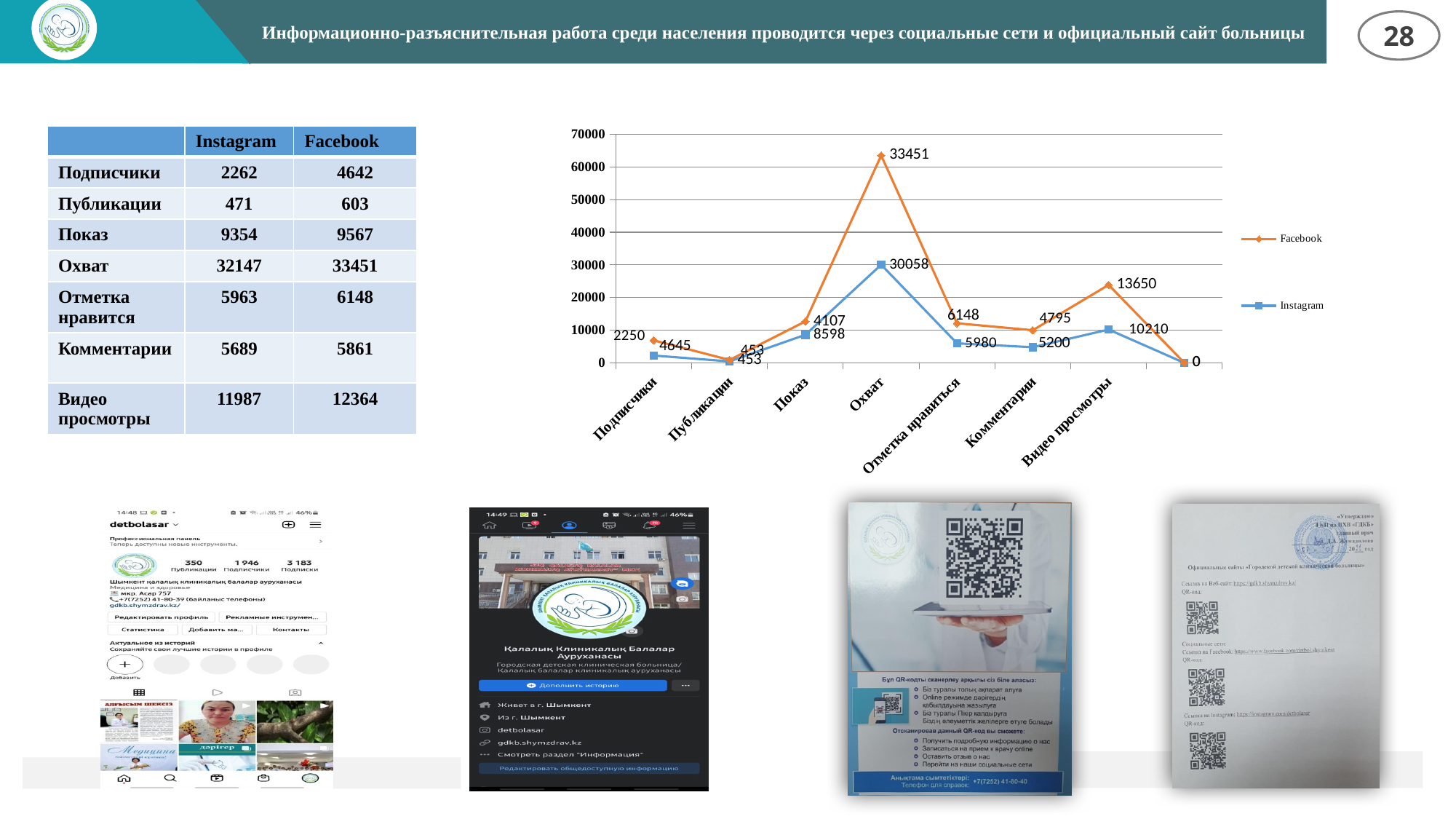
What is the Facebook value for Видео просмотры in the chart? 13650 What is the difference between the Facebook and Instagram values for Охват in the chart? 3393 For Видео просмотры, which series has the larger value in the chart, Facebook or Instagram? Facebook What is the Facebook value for Охват in the chart? 33451 How many series does the chart legend list? 2 Which category has the highest Instagram value in the chart? Охват What is the Instagram value for Охват in the chart? 30058 Which category has the highest Facebook value in the chart? Охват What kind of chart is shown on the slide? line chart Which two series are listed in the chart legend? Facebook and Instagram How many labeled categories are on the x axis of the chart? 7